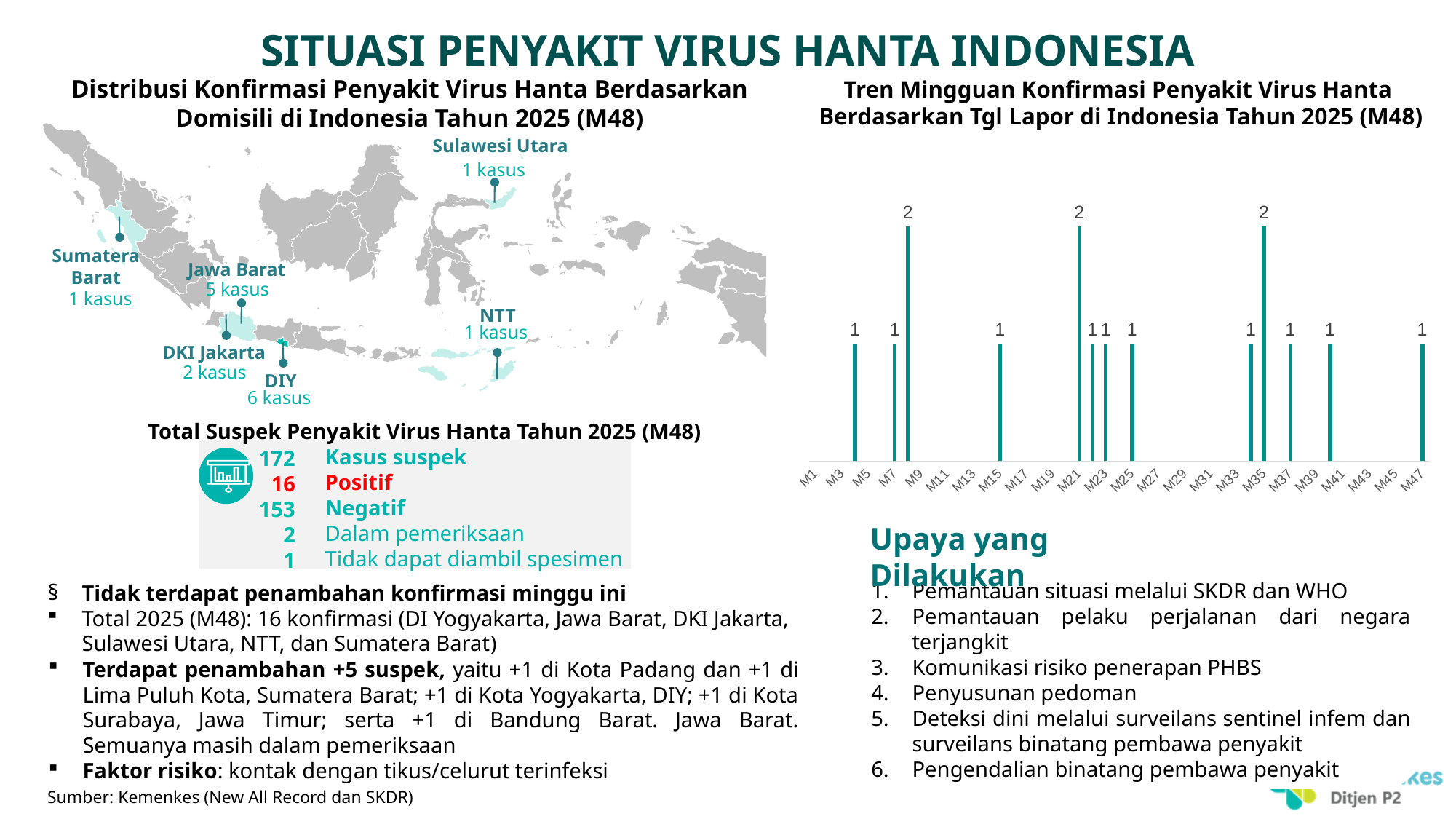
What is the first label on the x axis of the weekly trend bar chart on the right? M1 In the weekly trend bar chart on the right, what is the value of the leftmost bar? 1 What kind of chart is 'Tren Mingguan Konfirmasi Penyakit Virus Hanta Berdasarkan Tgl Lapor di Indonesia Tahun 2025 (M48)'? bar chart In the weekly trend bar chart on the right, what is the value of the rightmost bar? 1 How many bars are plotted in the weekly trend bar chart on the right? 13 What is the last label on the x axis of the weekly trend bar chart on the right? M47 In the weekly trend bar chart on the right, how many bars have a value of 2? 3 What is the sum of all bar values in the weekly trend bar chart on the right? 16 In the weekly trend bar chart on the right, what is the lowest value shown on any bar? 1 In the weekly trend bar chart on the right, what is the highest value shown on any bar? 2 In the weekly trend bar chart on the right, what is the value of the third bar from the left? 2 In the weekly trend bar chart on the right, which is larger: the first bar from the left or the third bar from the left? the third bar